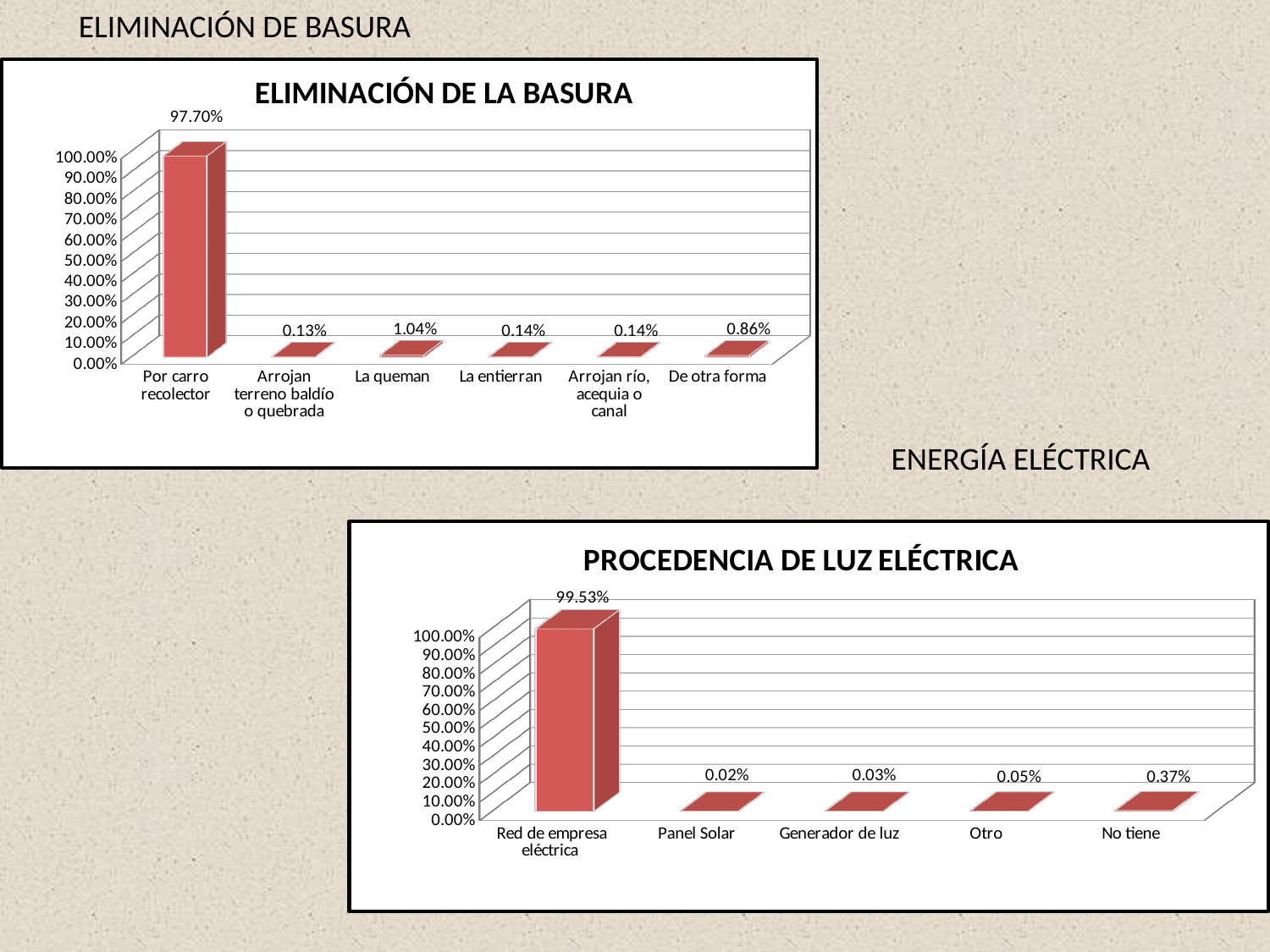
In the 'PROCEDENCIA DE LUZ ELÉCTRICA' chart, what is the value for 'Red de empresa eléctrica'? 99.53% In the 'ELIMINACIÓN DE LA BASURA' chart, what is the value for 'Por carro recolector'? 97.70% In the 'ELIMINACIÓN DE LA BASURA' chart, which is larger, 'De otra forma' or 'La entierran'? De otra forma In the 'PROCEDENCIA DE LUZ ELÉCTRICA' chart, which category has the lowest value? Panel Solar In the 'ELIMINACIÓN DE LA BASURA' chart, what is the difference between 'La queman' and 'De otra forma'? 0.18% What type of chart is the 'PROCEDENCIA DE LUZ ELÉCTRICA' chart? Bar chart In the 'PROCEDENCIA DE LUZ ELÉCTRICA' chart, how many categories are shown? 5 In the 'ELIMINACIÓN DE LA BASURA' chart, which category has the lowest value? Arrojan terreno baldío o quebrada In the 'PROCEDENCIA DE LUZ ELÉCTRICA' chart, what is the value for 'No tiene'? 0.37% In the 'ELIMINACIÓN DE LA BASURA' chart, how many categories are shown? 6 In the 'ELIMINACIÓN DE LA BASURA' chart, what is the value for 'La queman'? 1.04% In the 'PROCEDENCIA DE LUZ ELÉCTRICA' chart, what is the difference between 'No tiene' and 'Otro'? 0.32%